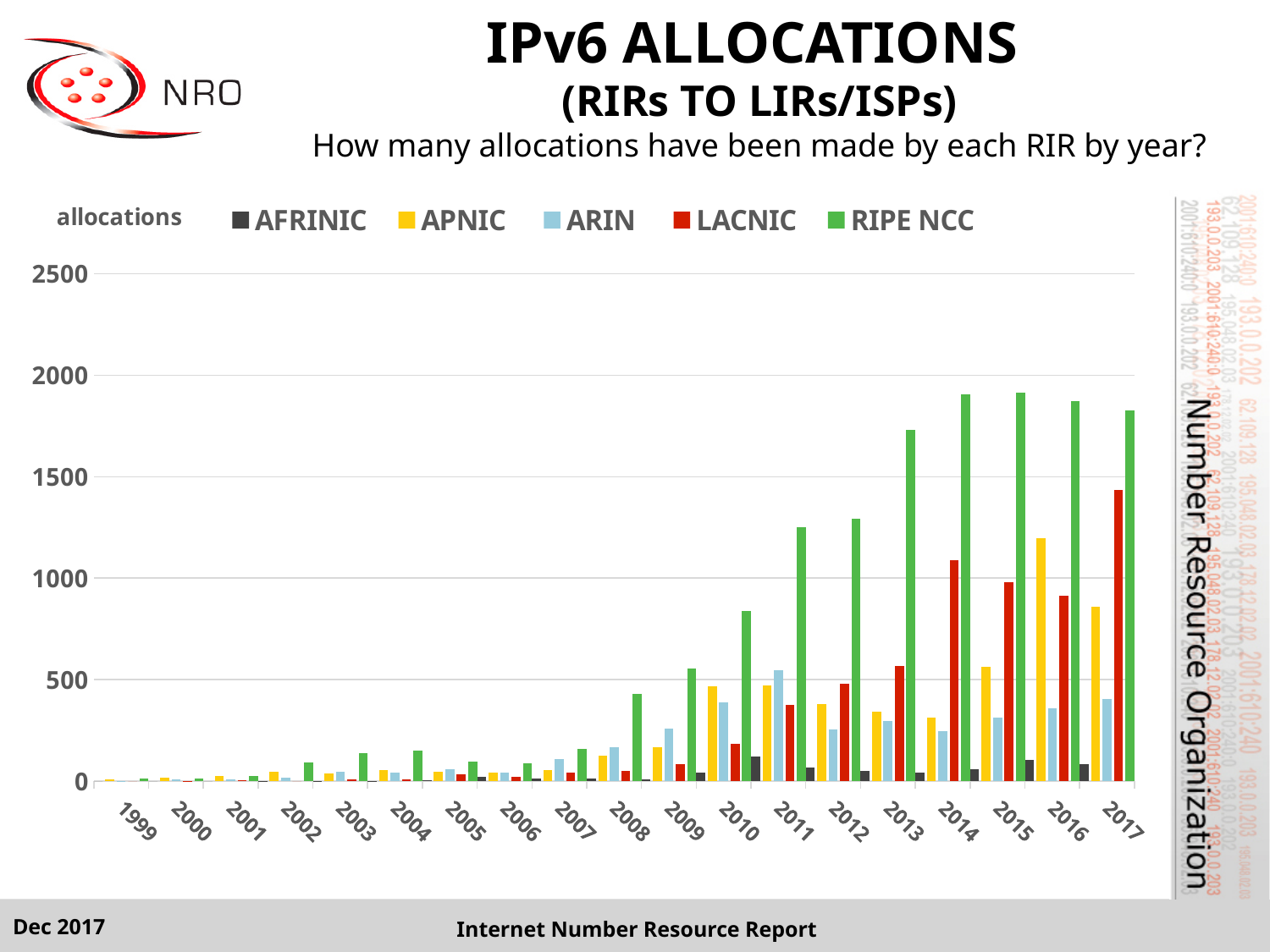
Which RIR has the highest number of allocations in 2017? RIPE NCC How many series does the legend list? 5 How many years are shown along the x axis? 19 Is the value for LACNIC in 2014 greater or less than 1000? greater Do the RIPE NCC allocations generally rise or fall from 1999 to 2015? rise In 2017, which is larger: the value for LACNIC or the value for APNIC? LACNIC What kind of chart is shown on the slide? bar chart Is the value for ARIN in 2017 greater or less than 500? less Which colour represents LACNIC in the legend? red Is the value for APNIC in 2015 greater or less than 1000? less Which RIR has the lowest number of allocations in 2017? AFRINIC